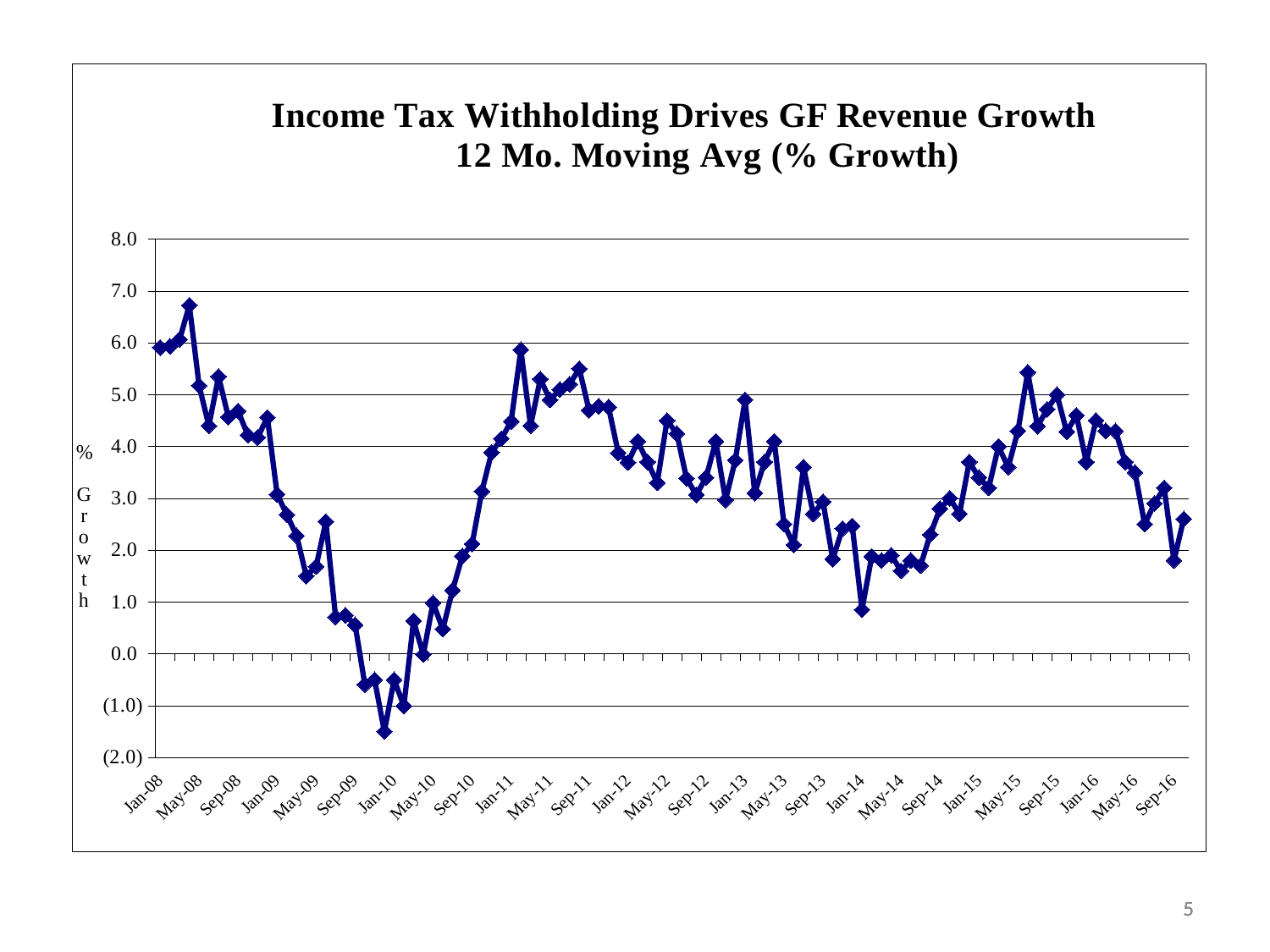
How many date labels are shown along the x axis? 27 What kind of chart is shown on the slide? Line chart What is the title of the chart? Income Tax Withholding Drives GF Revenue Growth 12 Mo. Moving Avg (% Growth) Is the value at Sep-16 greater or less than 2.0? less Is the value at Jan-08 greater or less than 5.0? greater What is the label on the vertical axis of the chart? % Growth Is the value at Jan-14 greater or less than 2.0? less Near which x-axis label does the line reach its lowest point? Jan-10 Do the values rise or fall between Jan-10 and Jan-11? rise Near which x-axis label does the line reach its highest point? May-08 Which is larger, the value at Jan-08 or the value at Sep-16? Jan-08